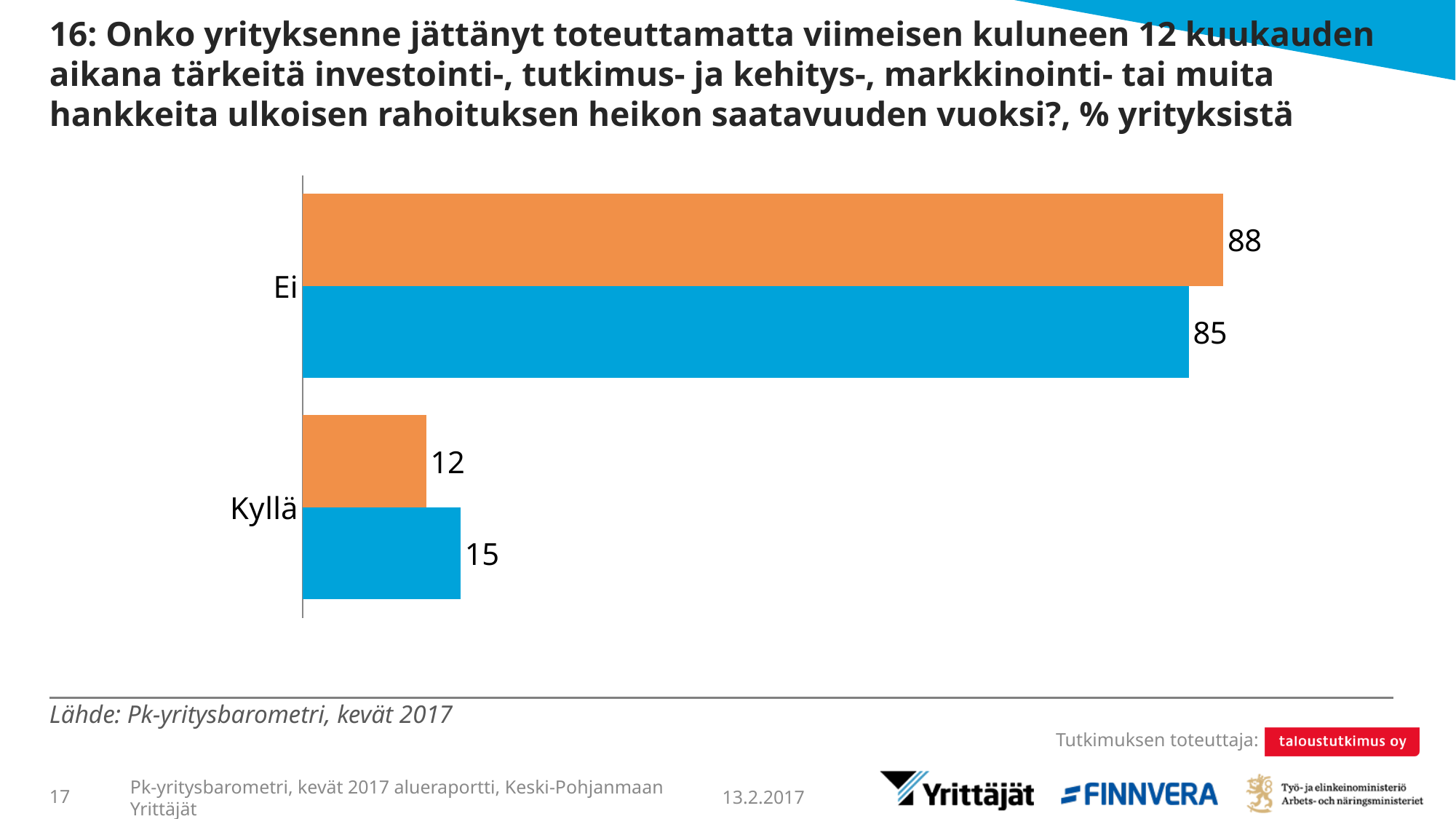
Which category has the lowest value among the blue bars? Kyllä What source is cited below the chart? Pk-yritysbarometri, kevät 2017 Which category has the highest value among the orange bars? Ei For "Kyllä", which bar is larger, the orange or the blue one? blue What is the value of the orange bar for "Kyllä"? 12 What is the value of the blue bar for "Kyllä"? 15 What is the difference between the orange and blue bars for "Ei"? 3 What is the difference between the blue and orange bars for "Kyllä"? 3 What is the value of the blue bar for "Ei"? 85 How many categories are shown on the chart? 2 What is the value of the orange bar for "Ei"? 88 What kind of chart is shown on the slide? bar chart